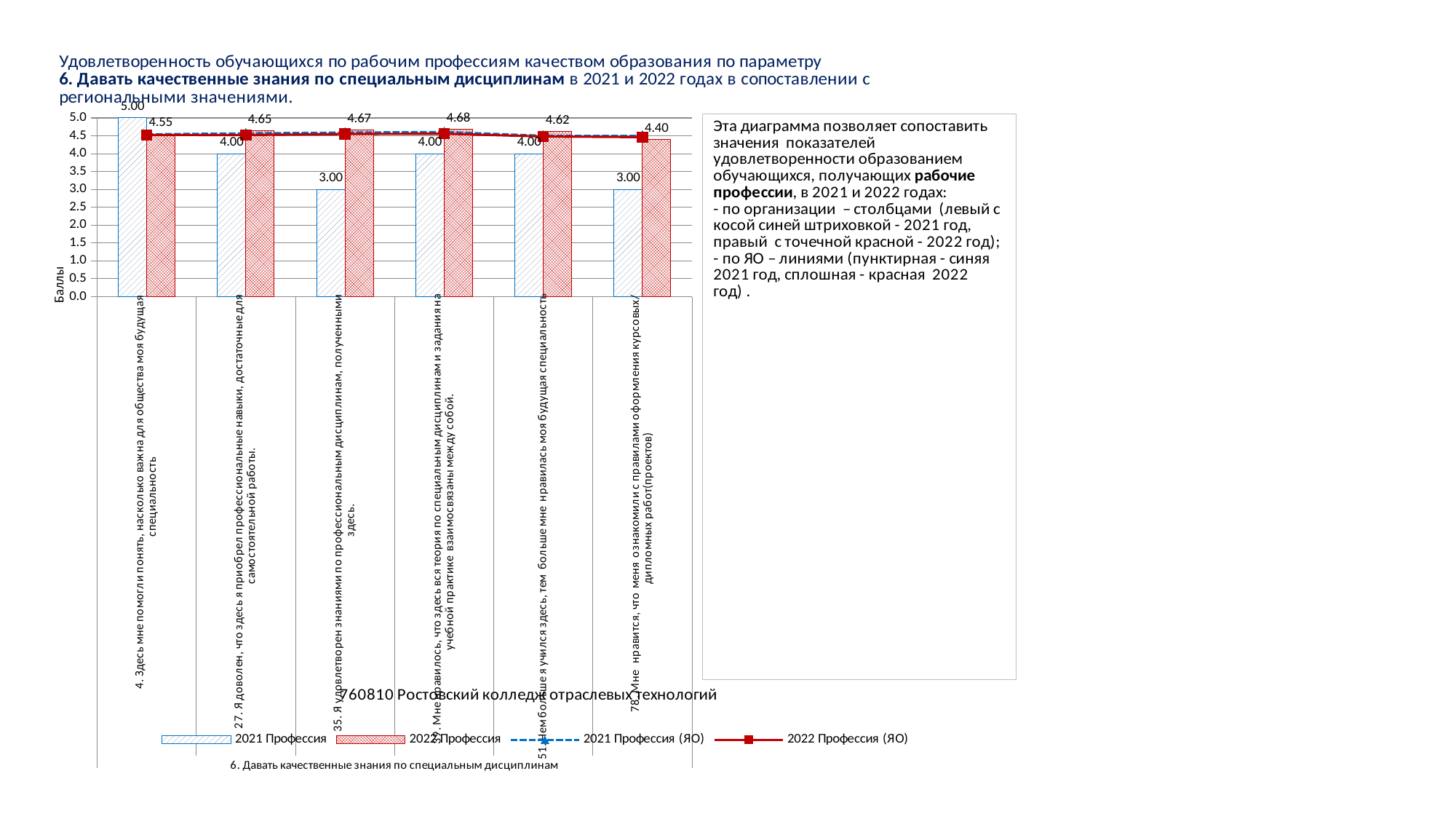
Is the 2022 Профессия bar for category 4 greater or less than 4.0? greater Which is larger: the 2021 Профессия value for category 4 or for category 27? Category 4 What is the value of the 2021 Профессия bar for category 27 (Я доволен, что здесь я приобрел профессиональные навыки)? 4.00 What is the difference between the 2021 Профессия values for category 4 and category 35? 2.00 Which category has the highest 2021 Профессия bar? 4. Здесь мне помогли понять, насколько важна для общества моя будущая специальность What is the title of the vertical axis of the chart? Баллы How many series does the chart legend list? 4 What is the value of the 2021 Профессия bar for category 4 (Здесь мне помогли понять, насколько важна для общества моя будущая специальность)? 5.00 How many categories are shown on the x axis of the chart? 6 What is the value of the 2021 Профессия bar for category 35 (Я удовлетворен знаниями по профессиональным дисциплинам, полученными здесь)? 3.00